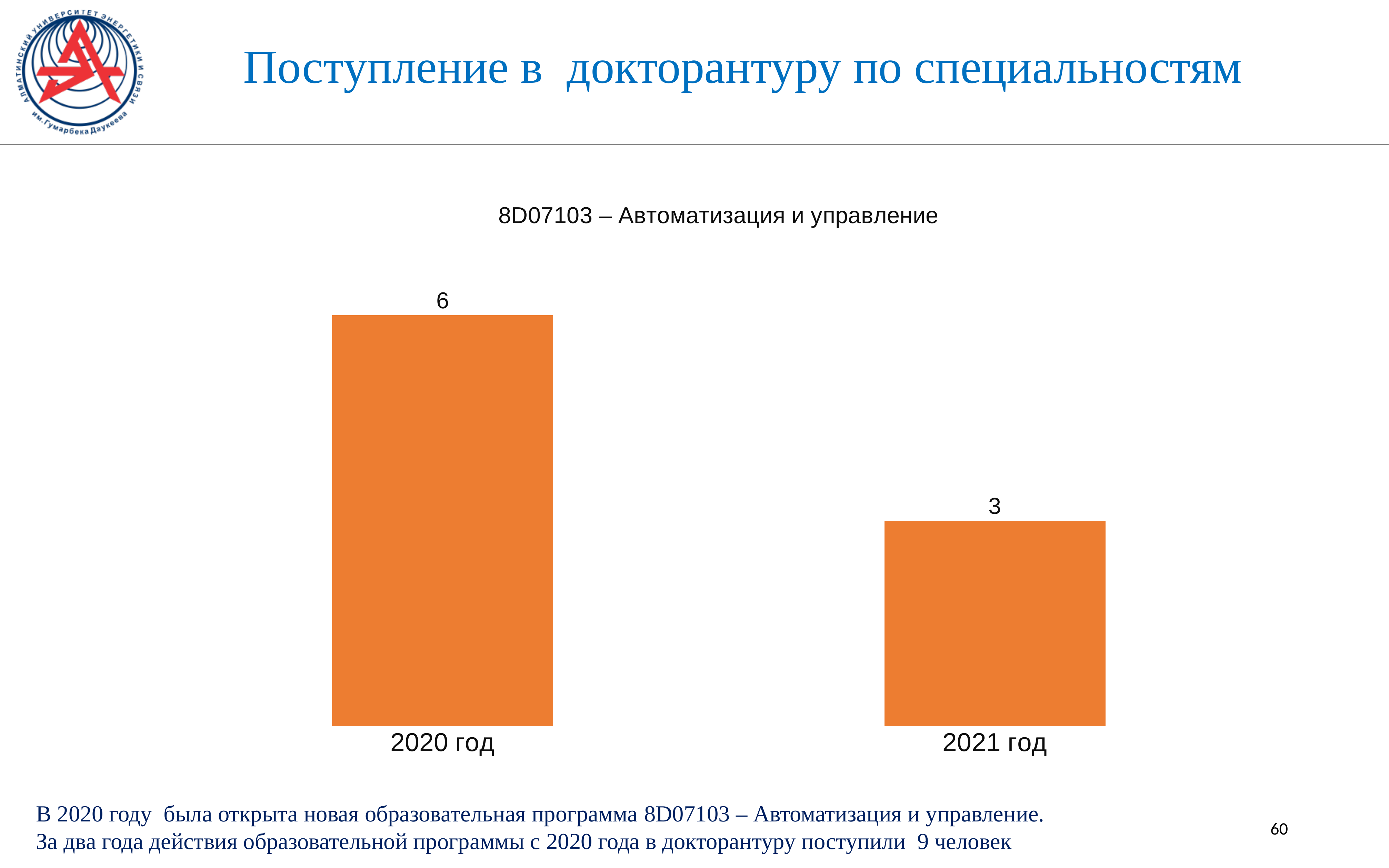
Which year has the lowest value? 2021 год What is the title of the chart? 8D07103 – Автоматизация и управление Do the values rise or fall from 2020 год to 2021 год? fall How many categories are shown in the chart? 2 What is the value for 2021 год? 3 What colour are the bars in the chart? orange What is the difference between the values for 2020 год and 2021 год? 3 Which is larger, the value for 2020 год or for 2021 год? 2020 год What kind of chart is shown on the slide? bar chart What is the value for 2020 год? 6 Which year has the highest value? 2020 год